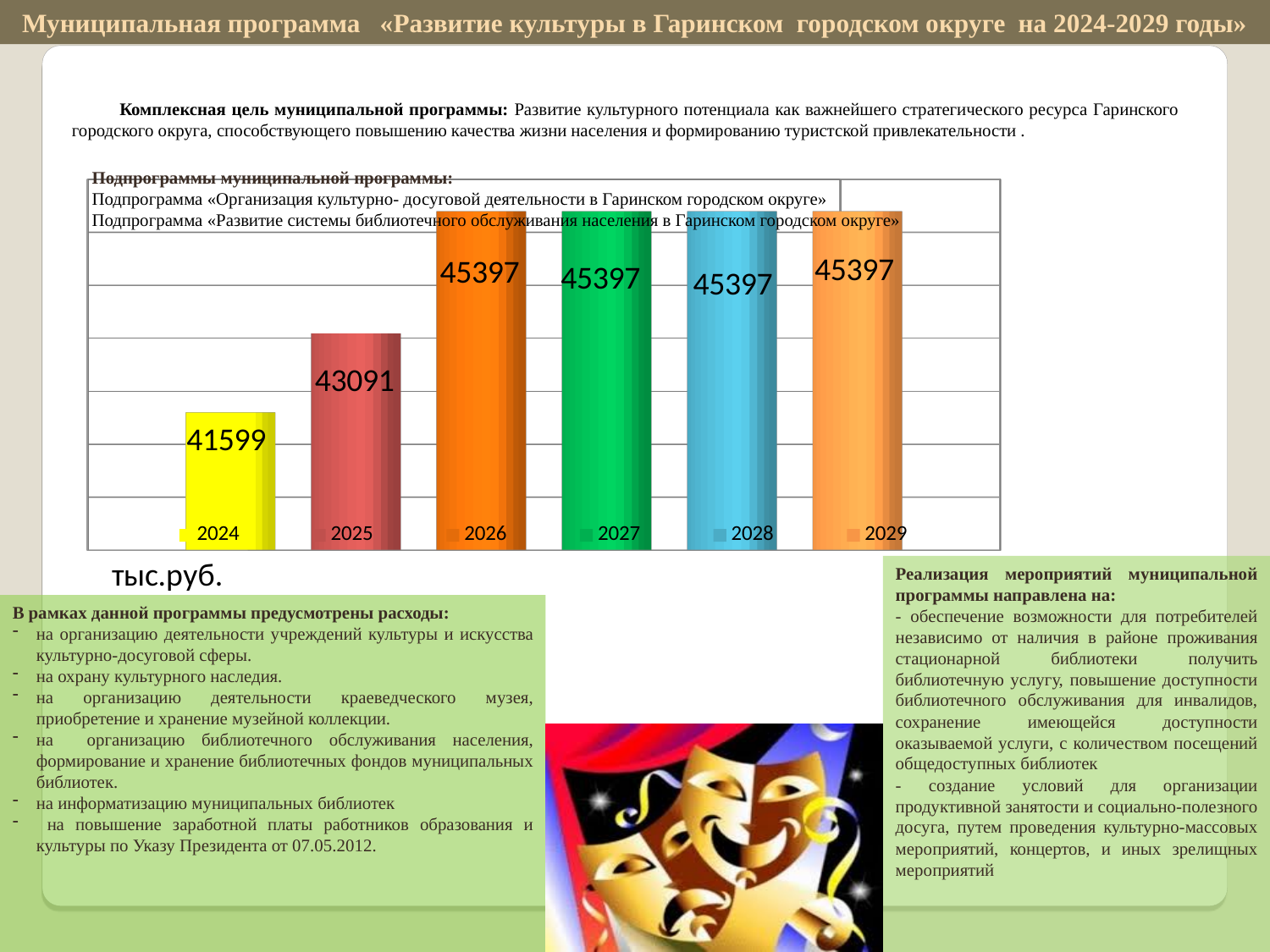
Do the values rise or fall from 2024 to 2026? rise What is the value for 2025? 43091 What is the difference between the values for 2026 and 2025? 2306 What kind of chart is shown on the slide? bar chart Which is larger, the value for 2024 or the value for 2025? 2025 What unit is given below the chart? тыс.руб. What is the value for 2026? 45397 What is the value for 2024? 41599 How many years are shown on the chart? 6 What is the value for 2029? 45397 What is the difference between the values for 2025 and 2024? 1492 Which year has the lowest value? 2024